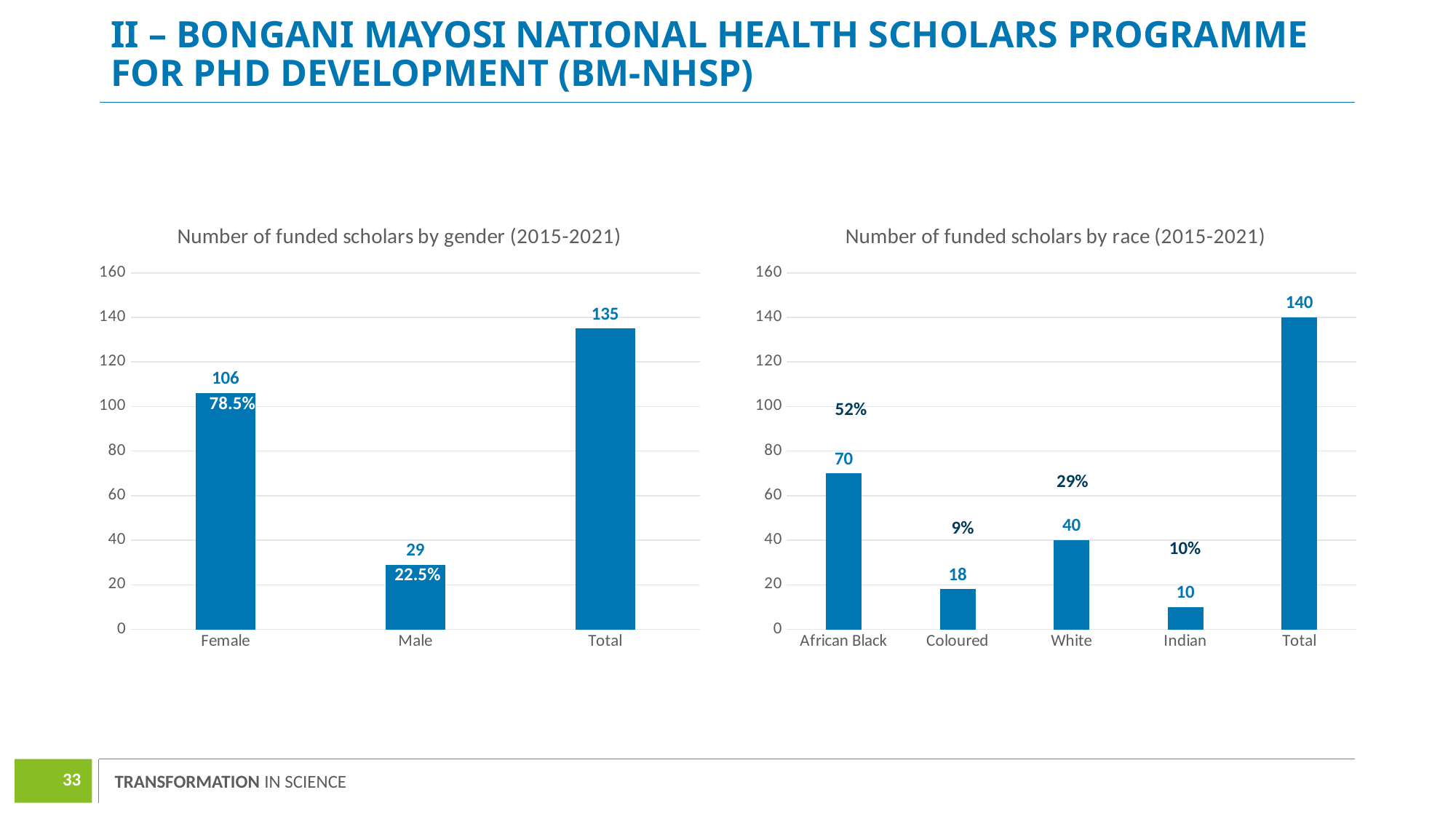
In the chart 'Number of funded scholars by gender (2015-2021)', which category has the lowest value? Male In the chart 'Number of funded scholars by gender (2015-2021)', what is the difference between the Female and Male values? 77 In the chart 'Number of funded scholars by gender (2015-2021)', what is the value for Female? 106 In the chart 'Number of funded scholars by gender (2015-2021)', how many categories are shown on the x axis? 3 In the chart 'Number of funded scholars by race (2015-2021)', what is the difference between the African Black and White values? 30 In the chart 'Number of funded scholars by race (2015-2021)', what is the value for White? 40 In the chart 'Number of funded scholars by race (2015-2021)', what percentage is shown above the Coloured bar? 9% What kind of chart is 'Number of funded scholars by race (2015-2021)'? Bar chart In the chart 'Number of funded scholars by race (2015-2021)', which is larger, the value for Coloured or the value for Indian? Coloured In the chart 'Number of funded scholars by race (2015-2021)', which category other than Total has the highest value? African Black In the chart 'Number of funded scholars by race (2015-2021)', which category has the lowest value? Indian In the chart 'Number of funded scholars by gender (2015-2021)', what percentage is shown on the Male bar? 22.5%